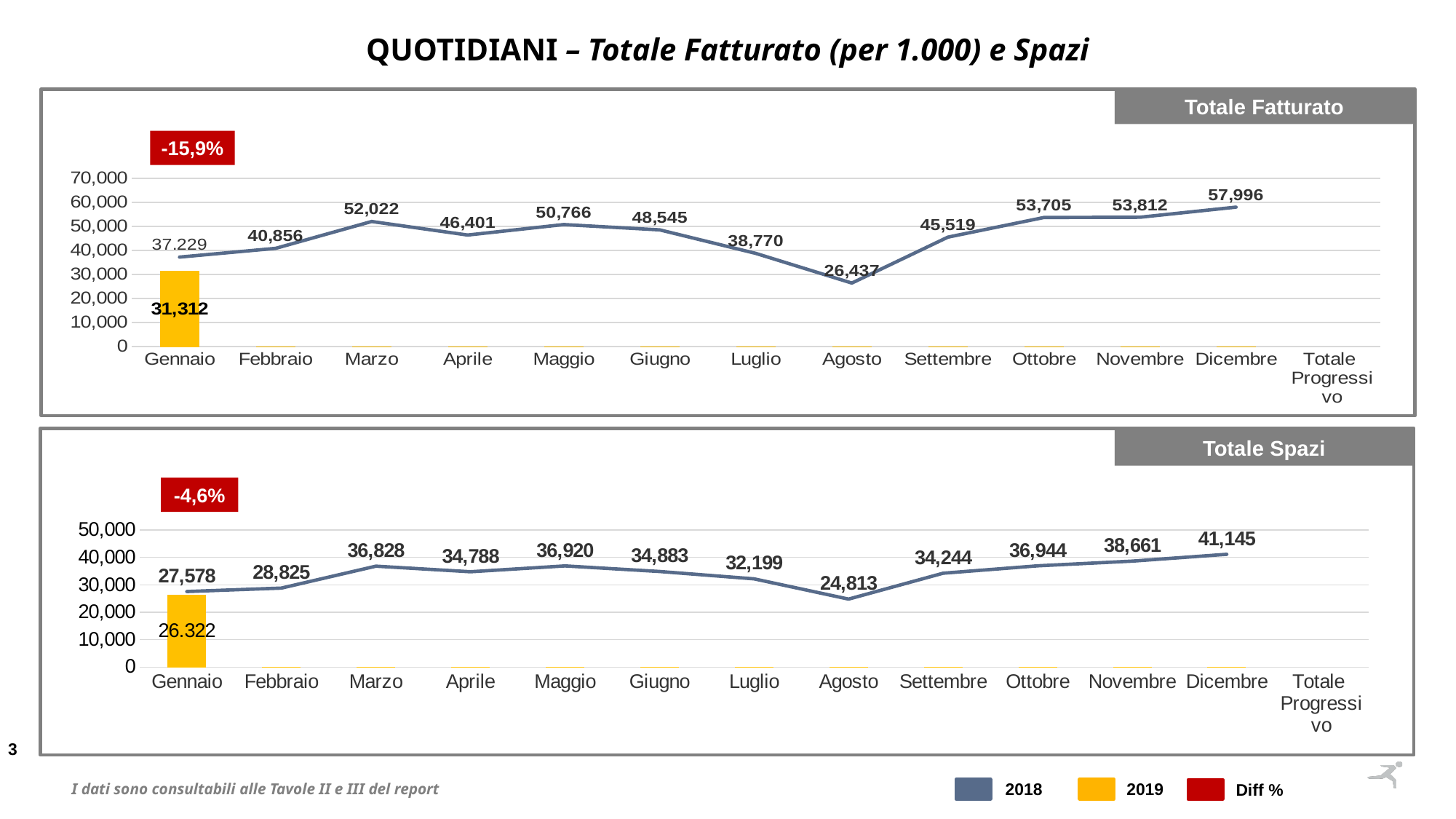
In the Totale Fatturato chart, which month has the lowest 2018 value? Agosto In the Totale Fatturato chart, what is the difference between the 2018 values for Dicembre and Agosto? 31,559 In the Totale Spazi chart, what is the 2018 value for Agosto? 24,813 In the Totale Spazi chart, which month has the highest 2018 value? Dicembre In the Totale Spazi chart, which 2018 value is larger, Marzo or Maggio? Maggio How many categories are shown on the x axis of the Totale Spazi chart? 13 In the Totale Fatturato chart, which month has the highest 2018 value? Dicembre How many series does the legend at the bottom of the slide list? 3 What Diff % value is shown in the Totale Fatturato chart? -15,9% In the Totale Fatturato chart, what is the 2018 value for Marzo? 52,022 In the Totale Fatturato chart, what is the 2019 value for Gennaio? 31,312 In the Totale Spazi chart, what is the difference between the 2018 values for Dicembre and Gennaio? 13,567